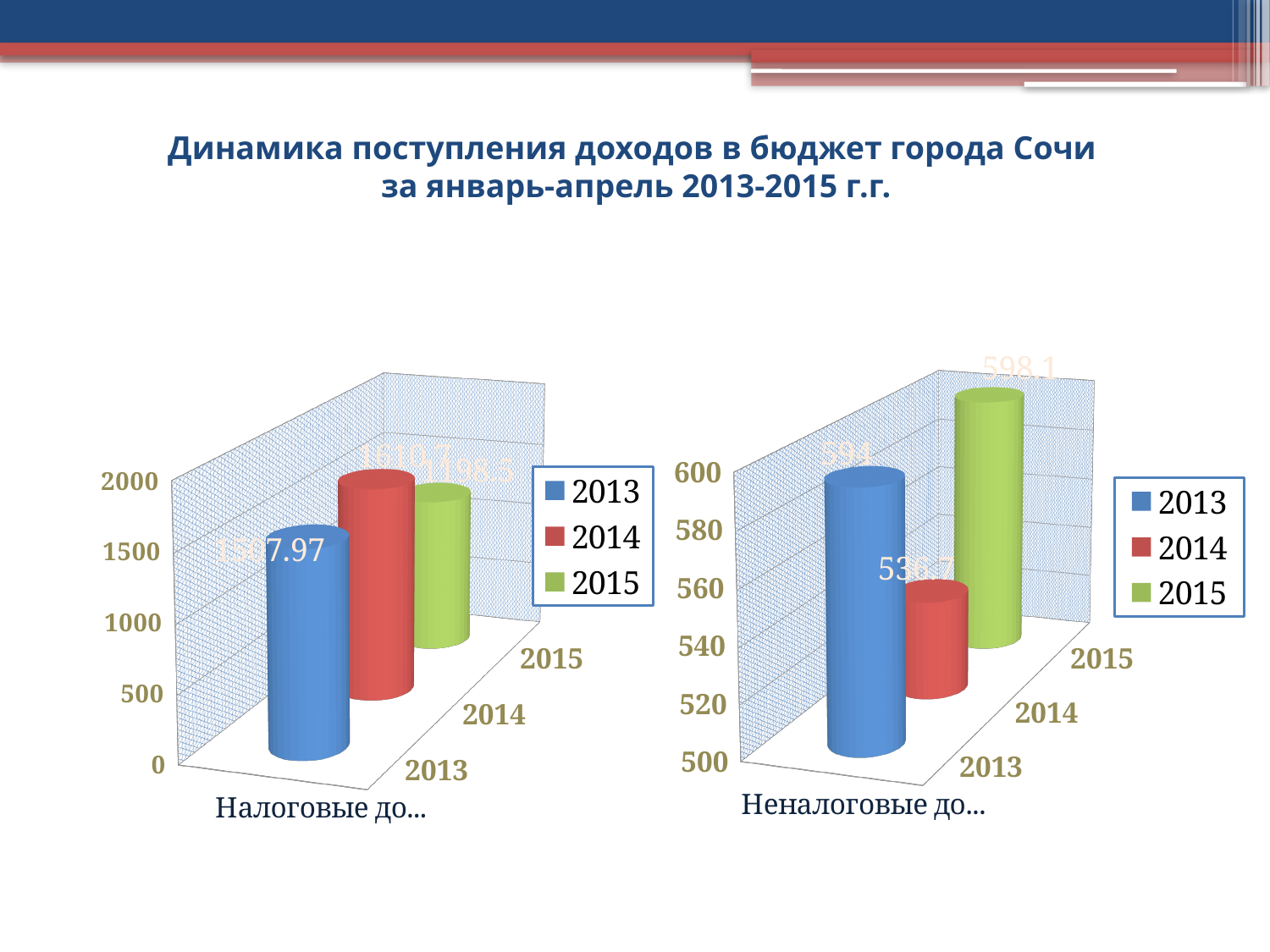
In the left chart (Налоговые доходы), what is the value for 2015? 1198.5 In the right chart (Неналоговые доходы), which year has the lowest value? 2014 In the left chart (Налоговые доходы), what is the value for 2013? 1507.97 In the right chart (Неналоговые доходы), what is the value for 2014? 536.7 In the right chart (Неналоговые доходы), what is the difference between the 2013 value and the 2014 value? 57.3 In the right chart (Неналоговые доходы), what is the value for 2015? 598.1 In the right chart (Неналоговые доходы), is the value for 2014 greater or less than 560? less In the left chart (Налоговые доходы), which year has the highest value? 2014 What kind of chart is the left chart (Налоговые доходы)? Bar chart How many series does the legend of the right chart (Неналоговые доходы) list? 3 In the left chart (Налоговые доходы), which is larger: the value for 2013 or the value for 2015? 2013 In the left chart (Налоговые доходы), what is the difference between the 2014 value and the 2013 value? 102.73